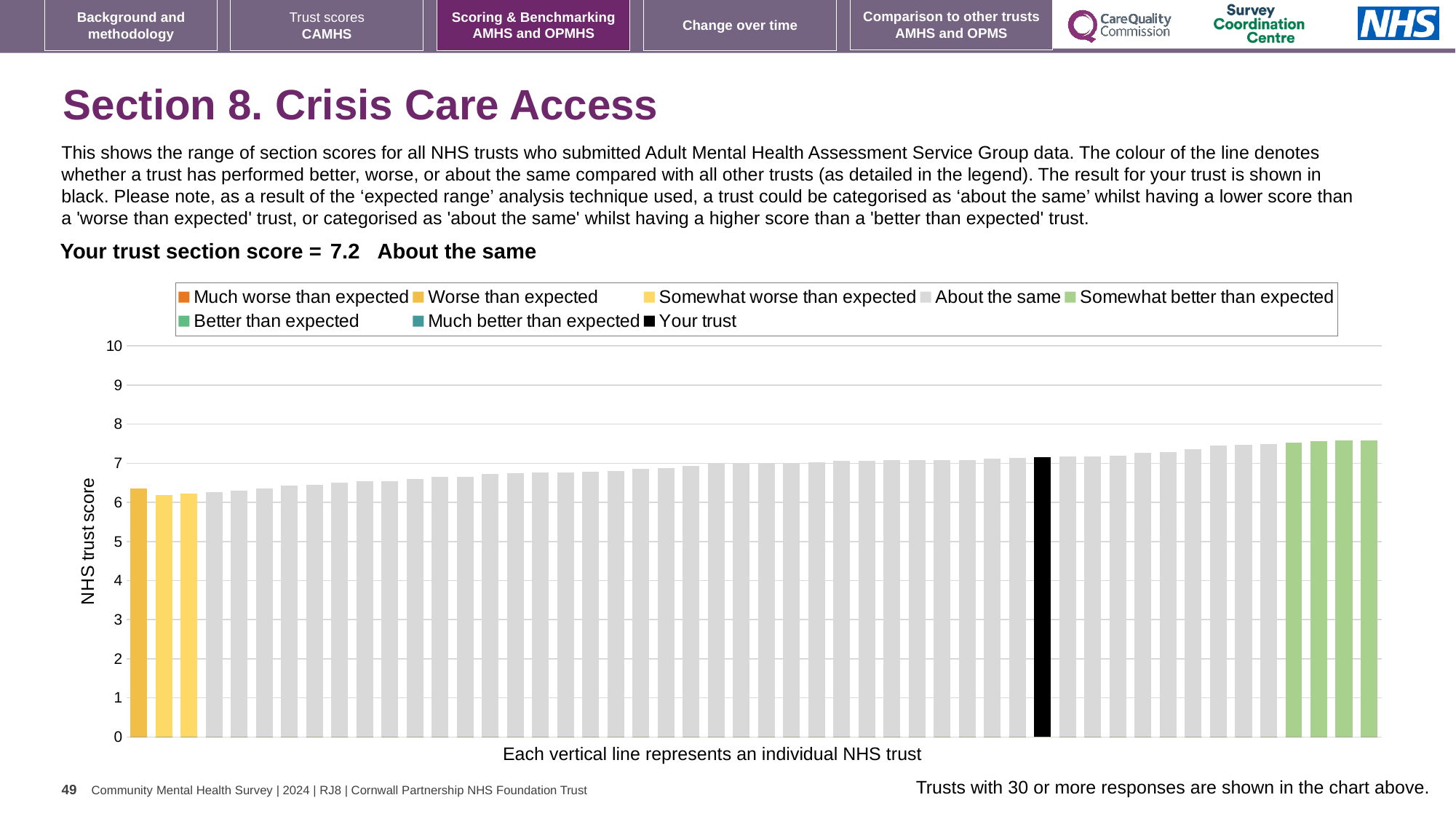
Which is larger: the black 'Your trust' bar or the leftmost bar in the chart? the black 'Your trust' bar What colour does the legend assign to 'Your trust'? black What kind of chart is shown on the slide? bar chart How many entries does the chart legend list? 8 Is the value of the black 'Your trust' bar greater or less than 7? greater What is the label on the vertical axis of the chart? NHS trust score How many bars are coloured black in the chart? 1 What is the section score for your trust shown on the slide? 7.2 Is the value of the tallest bar in the chart greater or less than 8? less Do the bar values rise or fall from left to right along the x axis? rise How many bars are coloured green (somewhat better than expected) in the chart? 4 Is the value of the shortest bar in the chart greater or less than 6? greater